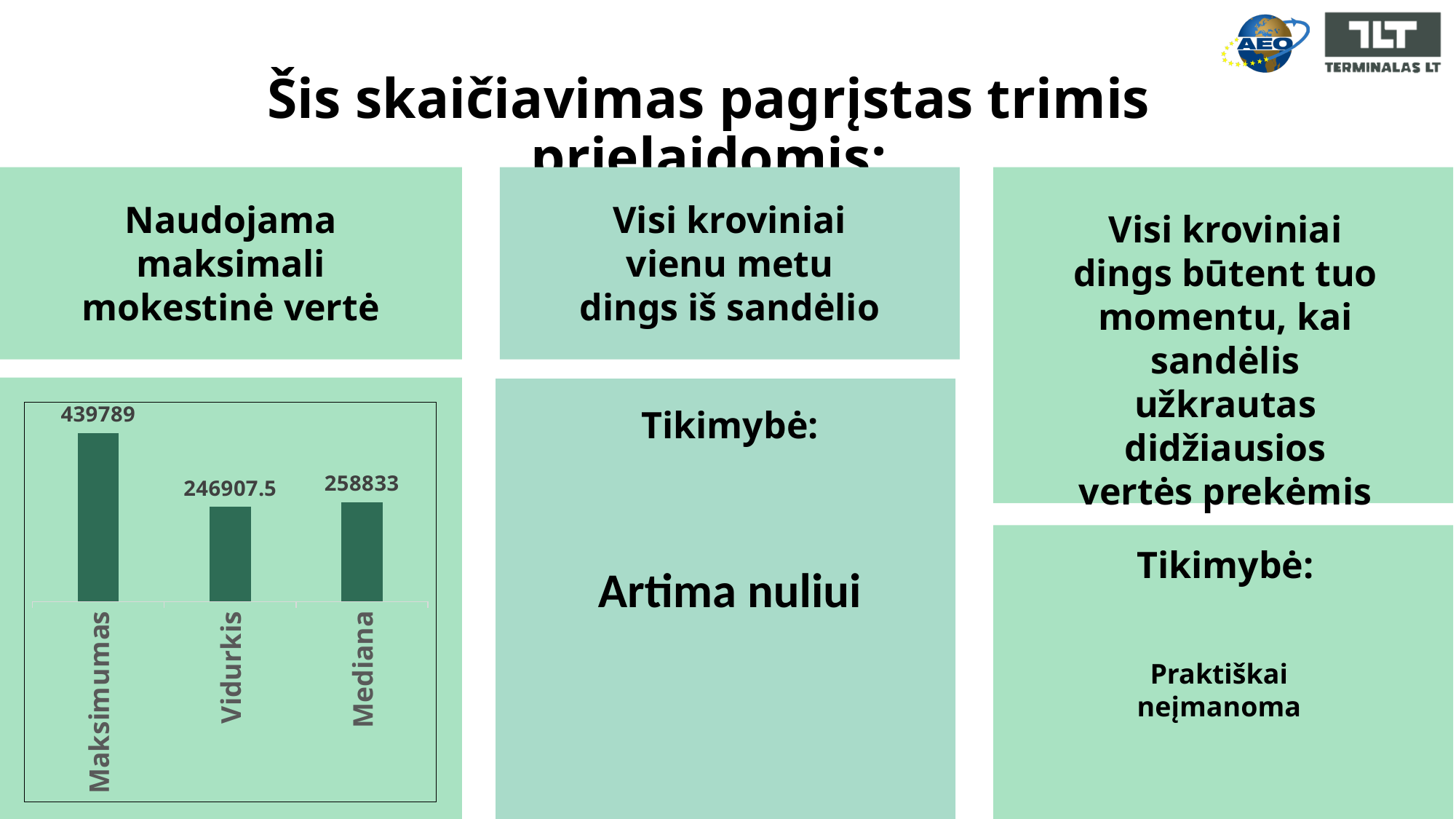
Which is larger, the value for Mediana or the value for Vidurkis? Mediana Which category has the lowest value in the chart? Vidurkis What is the difference between the Mediana and Vidurkis values? 11925.5 What is the difference between the Maksimumas and Vidurkis values? 192881.5 Which category has the highest value in the chart? Maksimumas How many categories are shown in the chart? 3 What is the value of the Vidurkis bar? 246907.5 What is the heading of the panel directly above the chart? Naudojama maksimali mokestinė vertė What is the value of the Maksimumas bar? 439789 What kind of chart is shown on the slide? bar chart What is the value of the Mediana bar? 258833 What is the difference between the Maksimumas and Mediana values? 180956